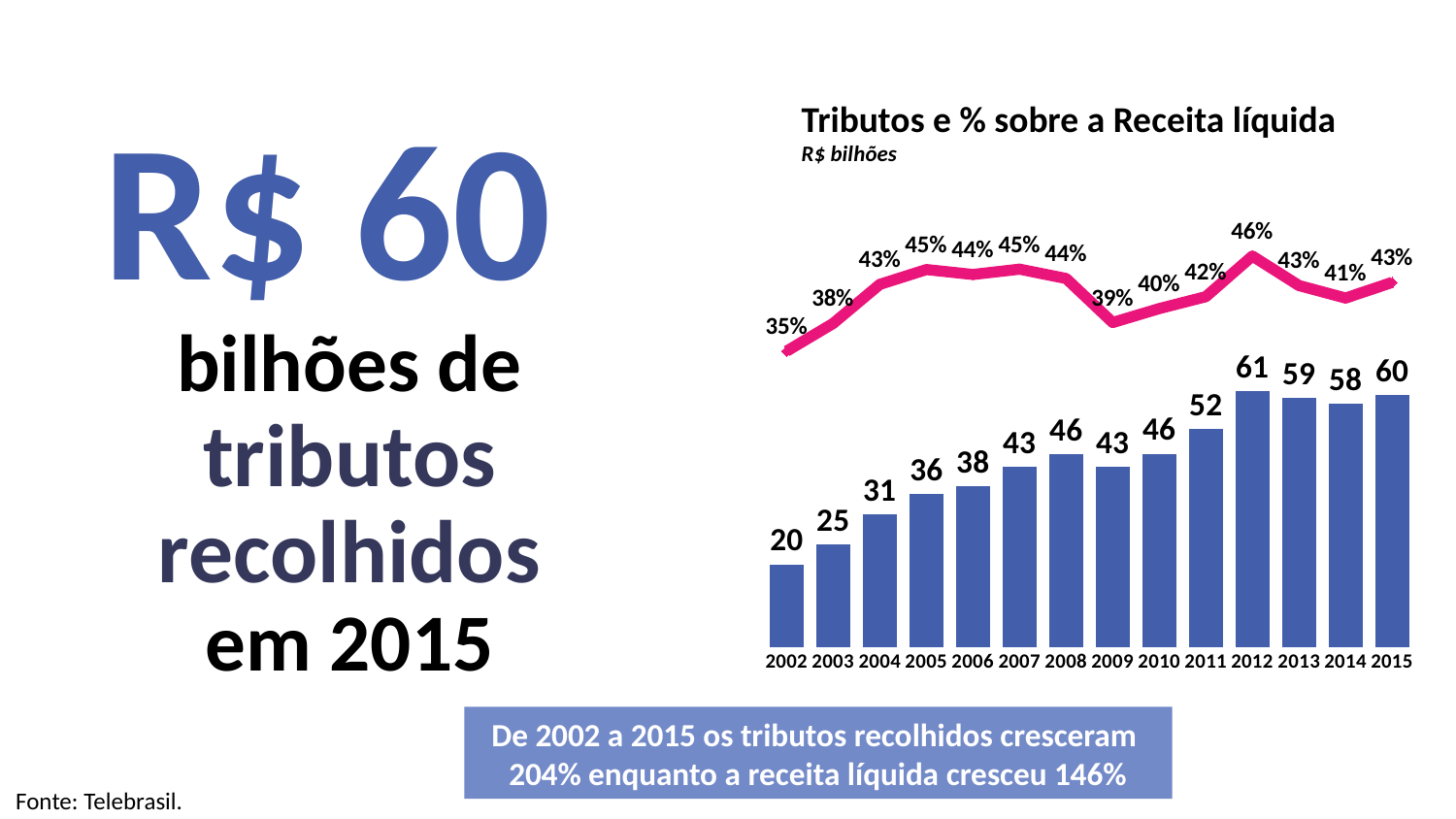
What percentage of receita líquida did tributos represent in 2012? 46% What is the value of tributos (R$ bilhões) for 2015? 60 What is the difference between the tributos value for 2015 and for 2002? 40 Which year has a higher tributos value, 2011 or 2013? 2013 Which year has the lowest value of tributos in the bar chart? 2002 Do the tributos values generally rise or fall from 2002 to 2012? Rise What is the lowest percentage shown on the line for % sobre a Receita líquida? 35% What is the title of the chart? Tributos e % sobre a Receita líquida How many years are shown on the x axis of the chart? 14 What kind of chart is used to show the tributos values in R$ bilhões? Bar chart Which year has the highest value of tributos in the bar chart? 2012 What percentage of receita líquida did tributos represent in 2009? 39%